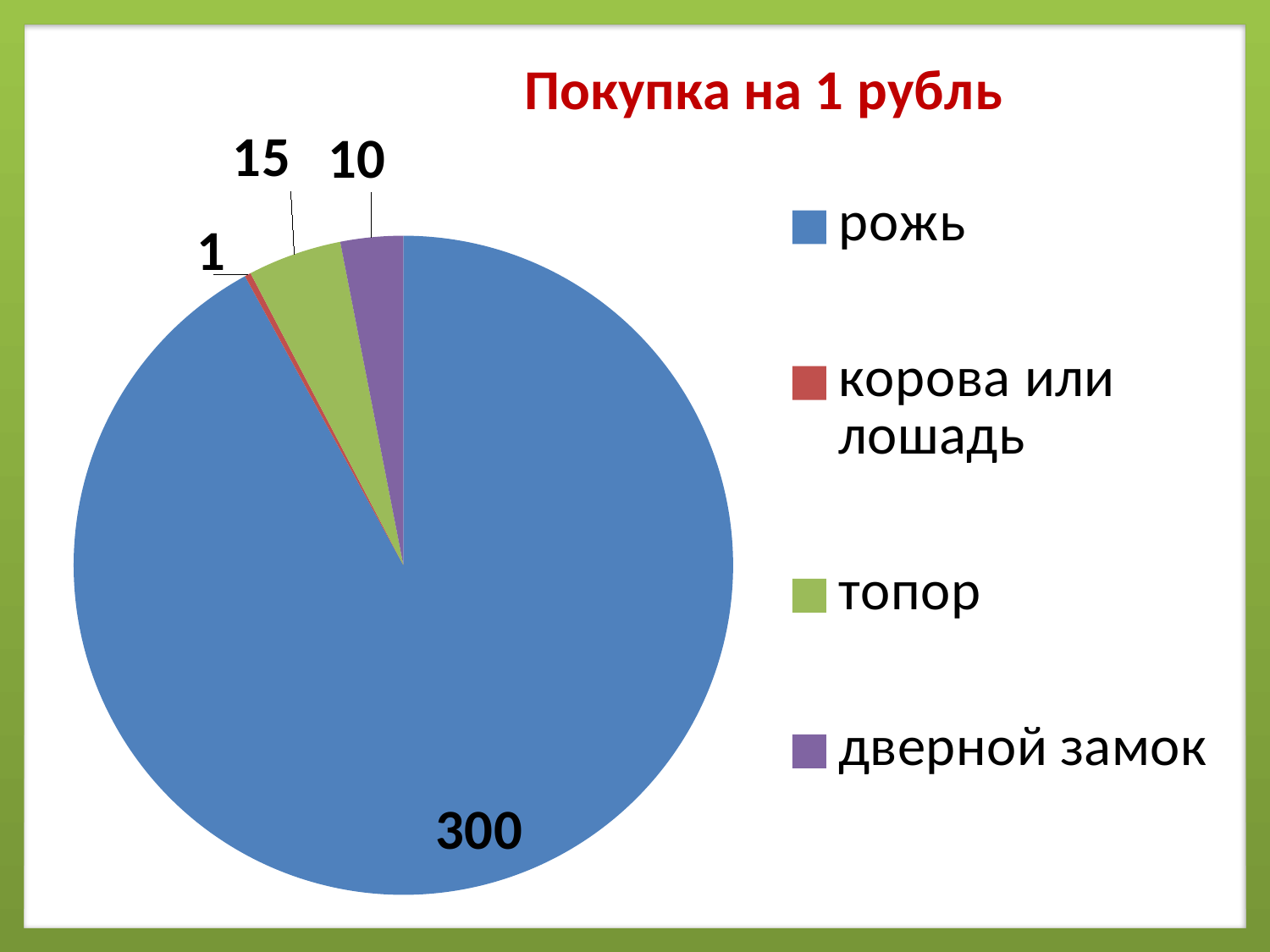
Which is larger, the value for топор or the value for дверной замок? топор What type of chart is shown on the slide? pie chart Which category has the largest slice of the pie chart? рожь Which category has the smallest slice of the pie chart? корова или лошадь What is the value for корова или лошадь in the pie chart? 1 What is the value for рожь in the pie chart? 300 What is the difference between the values for рожь and топор? 285 How many categories does the pie chart show? 4 What is the difference between the values for топор and дверной замок? 5 What is the title of the chart? Покупка на 1 рубль What is the value for топор in the pie chart? 15 What is the value for дверной замок in the pie chart? 10